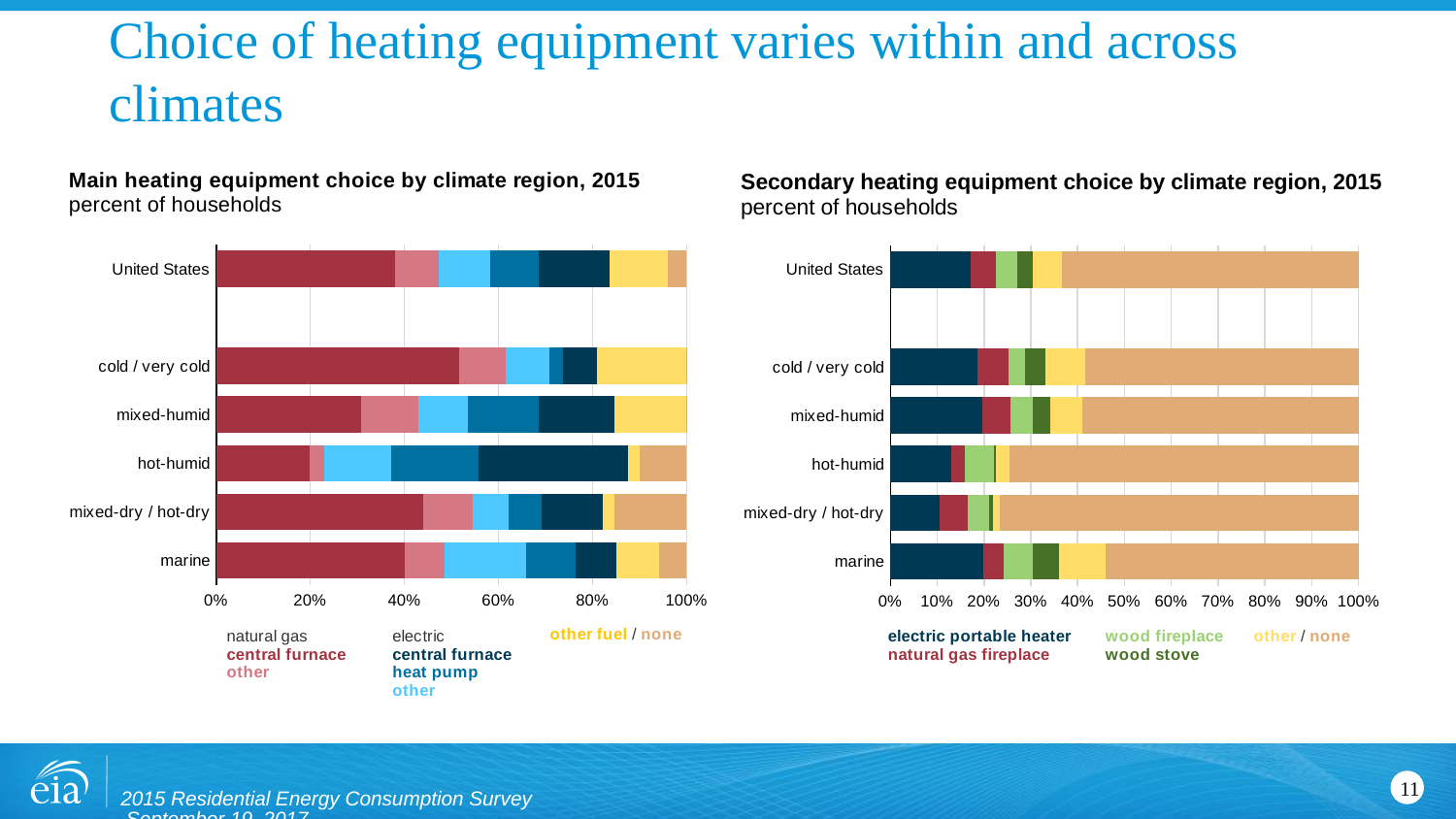
In the 'Main heating equipment choice by climate region, 2015' chart, is the natural gas central furnace share for cold / very cold greater or less than 40%? greater In the 'Main heating equipment choice by climate region, 2015' chart, is the natural gas central furnace share for mixed-humid greater or less than 40%? less What kind of chart is the 'Main heating equipment choice by climate region, 2015' chart? stacked bar chart How many climate region categories (including United States) are plotted in the 'Main heating equipment choice by climate region, 2015' chart? 6 In the 'Main heating equipment choice by climate region, 2015' chart, which region has a larger 'other fuel' share: cold / very cold or hot-humid? cold / very cold What unit is stated under the title of the 'Secondary heating equipment choice by climate region, 2015' chart? percent of households In the 'Secondary heating equipment choice by climate region, 2015' chart, what do the stacked segments of each bar total? 100% In the 'Main heating equipment choice by climate region, 2015' chart, which climate region has the largest share of natural gas central furnace? cold / very cold How many series does the legend of the 'Main heating equipment choice by climate region, 2015' chart list? 7 How many series does the legend of the 'Secondary heating equipment choice by climate region, 2015' chart list? 6 In the 'Secondary heating equipment choice by climate region, 2015' chart, is the electric portable heater share for United States greater or less than 10%? greater In the 'Main heating equipment choice by climate region, 2015' chart, which climate region has the smallest share of natural gas central furnace? hot-humid